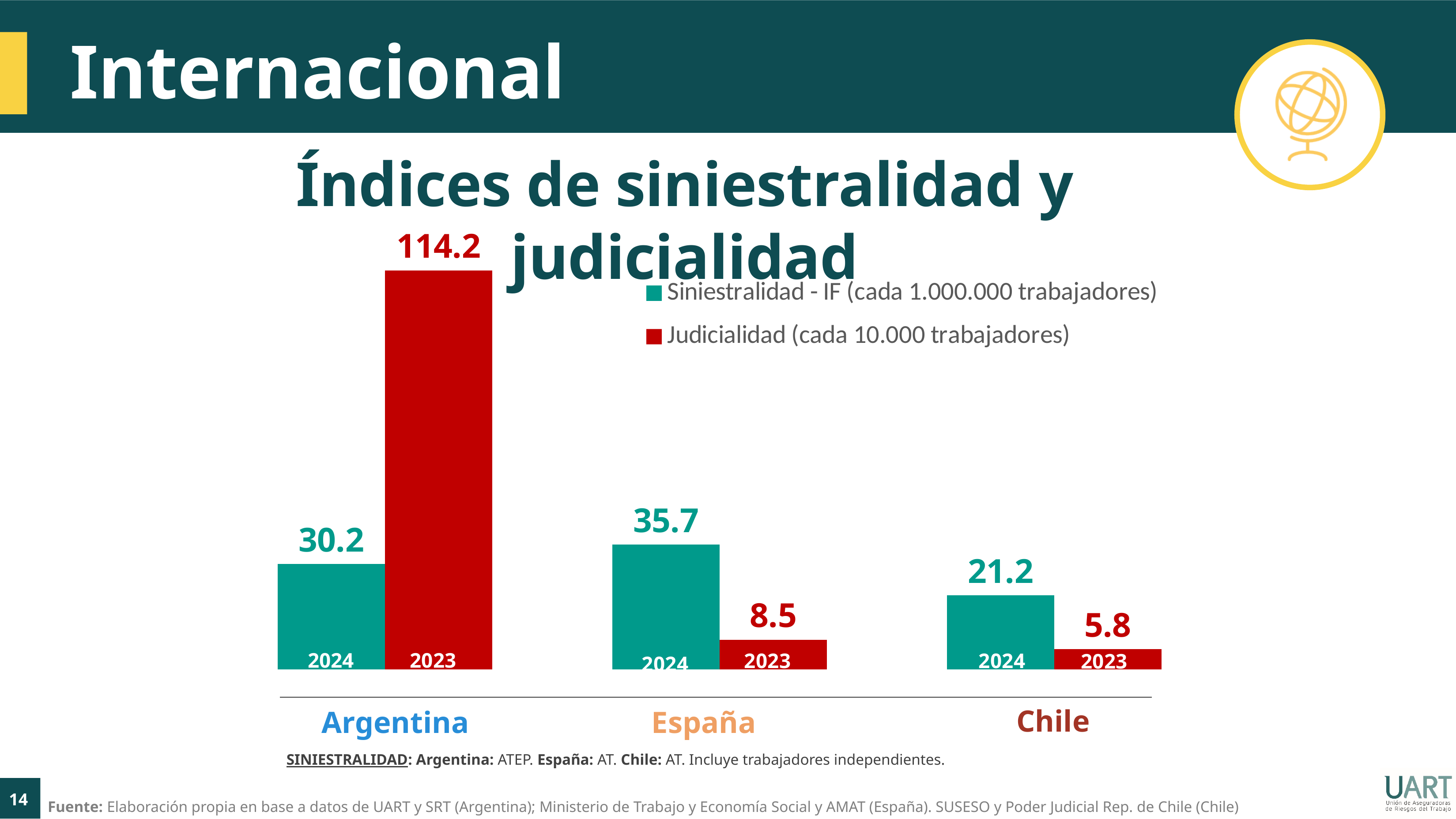
How many countries are shown on the x axis of the chart? 3 What is the Judicialidad value for Argentina? 114.2 Which country has the highest Siniestralidad - IF value? España What is the Judicialidad value for Chile? 5.8 What is the difference between the Judicialidad values for Argentina and España? 105.7 Which year is labelled on the Judicialidad bars? 2023 Which is larger, the Siniestralidad - IF value for Chile or the Judicialidad value for Chile? Siniestralidad - IF value for Chile What is the Siniestralidad - IF value for España? 35.7 What is the Siniestralidad - IF value for Argentina? 30.2 What type of chart is shown on the slide? Bar chart Which country has the lowest Judicialidad value? Chile How many series does the chart legend list? 2